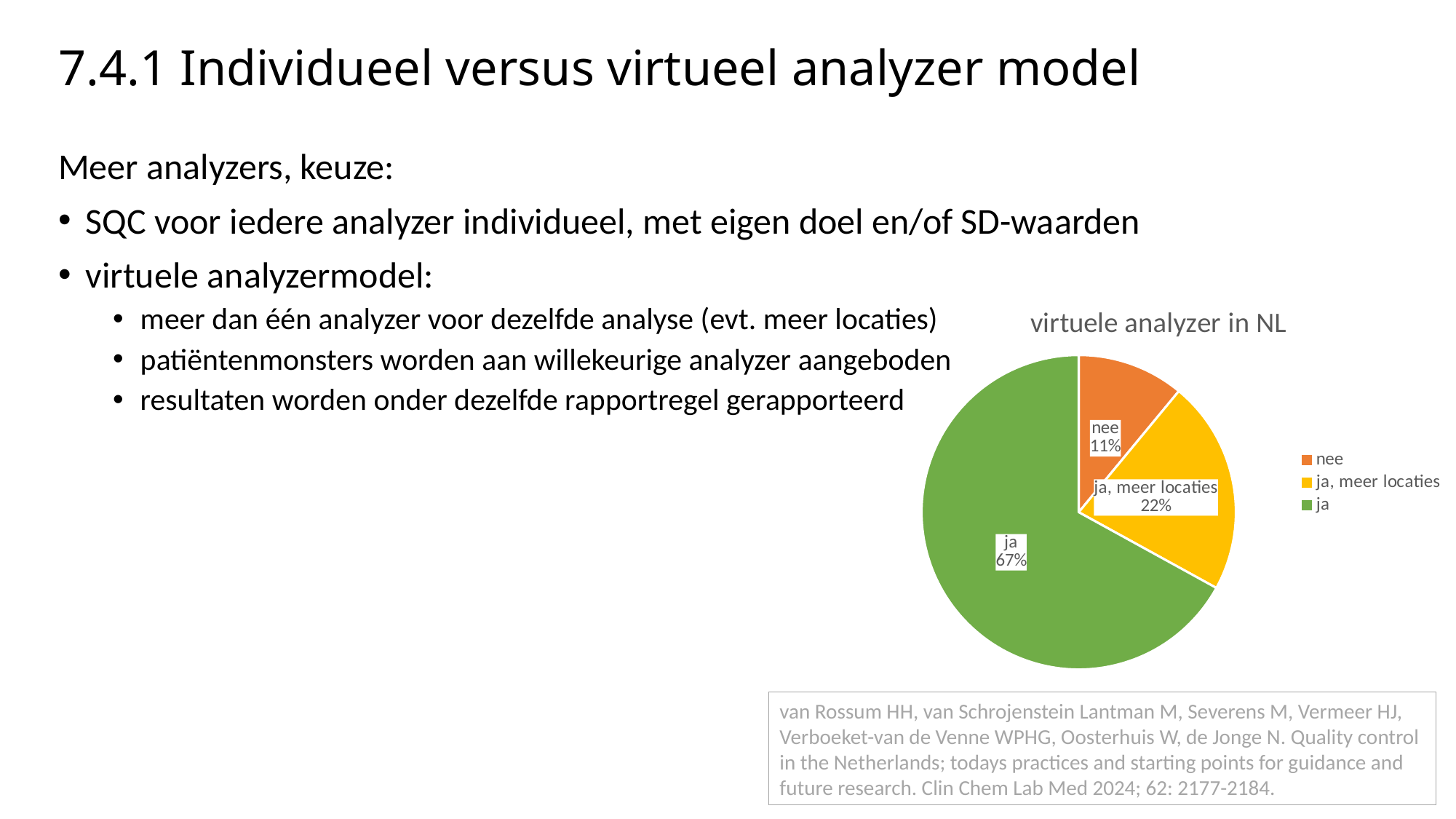
What kind of chart is shown on the slide? pie chart What is the title of the chart? virtuele analyzer in NL What is the difference in percentage points between the 'ja' slice and the 'ja, meer locaties' slice? 45 Which slice is larger, 'nee' or 'ja, meer locaties'? ja, meer locaties Which category has the smallest slice of the pie? nee What colour is the 'nee' slice in the pie chart? orange What share of the pie does the 'ja' slice represent? 67% How many slices does the pie chart have? 3 How many entries does the legend list? 3 What share of the pie does the 'nee' slice represent? 11% What share of the pie does the 'ja, meer locaties' slice represent? 22% Which category has the largest slice of the pie? ja